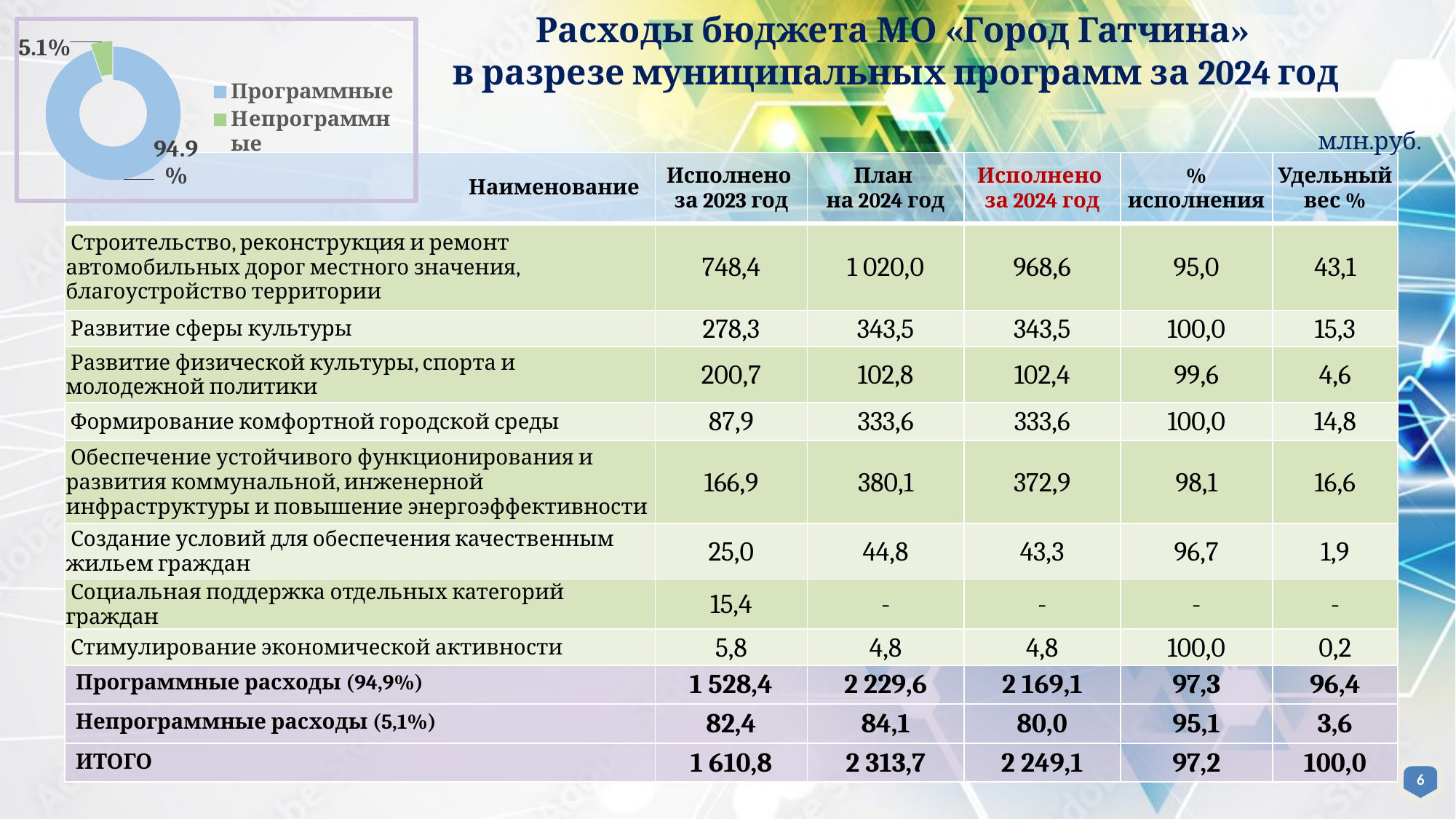
By how many percentage points does the Программные slice exceed the Непрограммные slice in the pie chart? 89.8 Which slice of the pie chart is the largest? Программные Which slice of the pie chart is the smallest? Непрограммные What share of the pie chart does the Непрограммные slice take? 5.1% In the pie chart, what share is labelled for Непрограммные? 5.1% In the pie chart, what share is labelled for Программные? 94.9% How many slices does the pie chart have? 2 In the pie chart, which is larger: Программные or Непрограммные? Программные How many entries does the legend of the pie chart list? 2 What colour is the Программные slice in the pie chart? blue What colour is the Непрограммные slice in the pie chart? green What kind of chart is shown in the top-left corner of the slide? doughnut chart